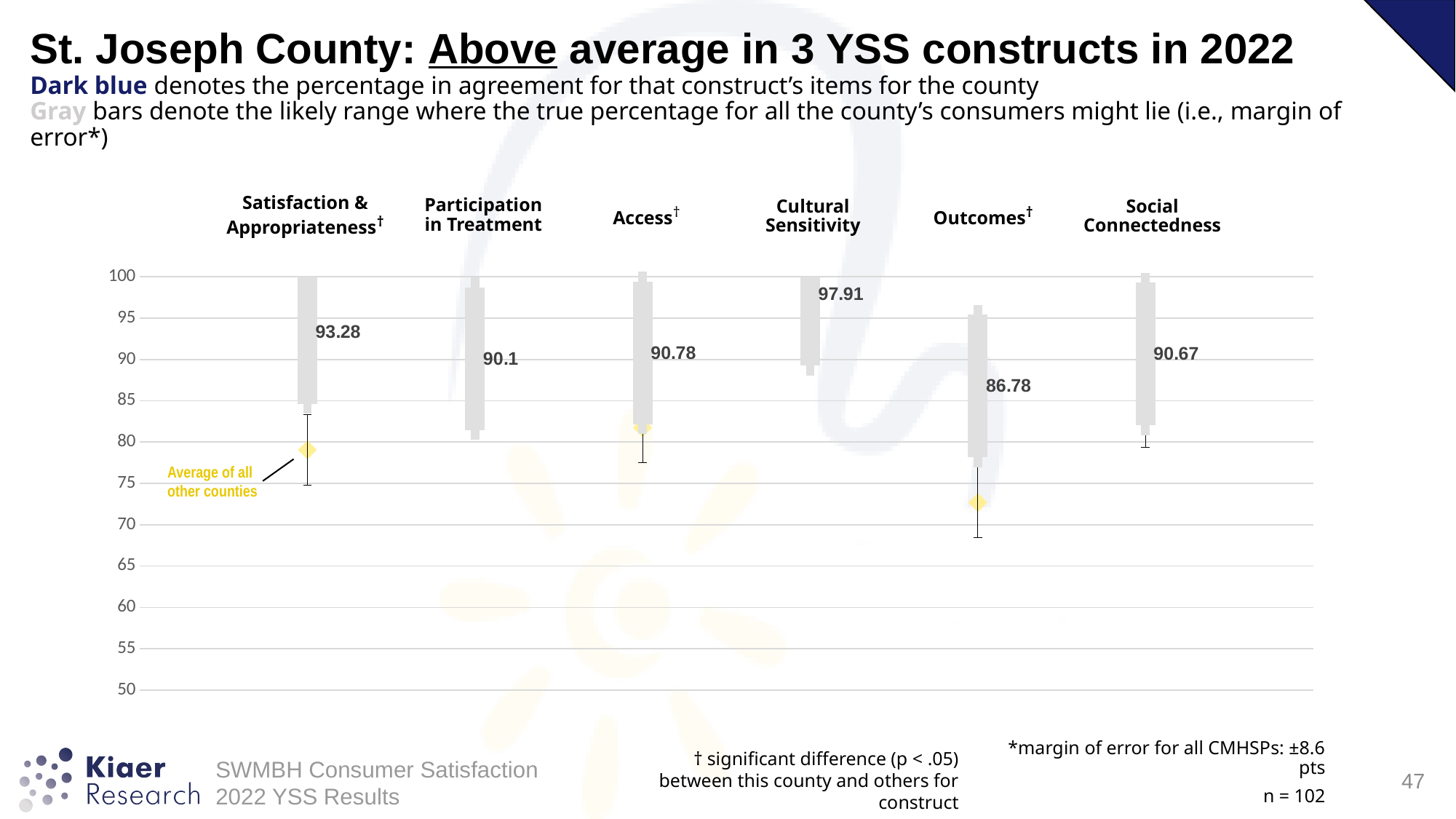
Is the value for Outcomes greater or less than 90? less What is the value shown for Social Connectedness? 90.67 What is the value shown for Outcomes? 86.78 Which is larger, the value for Access or the value for Participation in Treatment? Access What is the value shown for Satisfaction & Appropriateness? 93.28 Which construct has the lowest value? Outcomes What is the difference between the values for Cultural Sensitivity and Outcomes? 11.13 What is the difference between the values for Satisfaction & Appropriateness and Participation in Treatment? 3.18 What is the value shown for Cultural Sensitivity? 97.91 How many constructs are plotted on the chart? 6 According to the chart annotation, what do the yellow diamonds represent? Average of all other counties Which construct has the highest value? Cultural Sensitivity